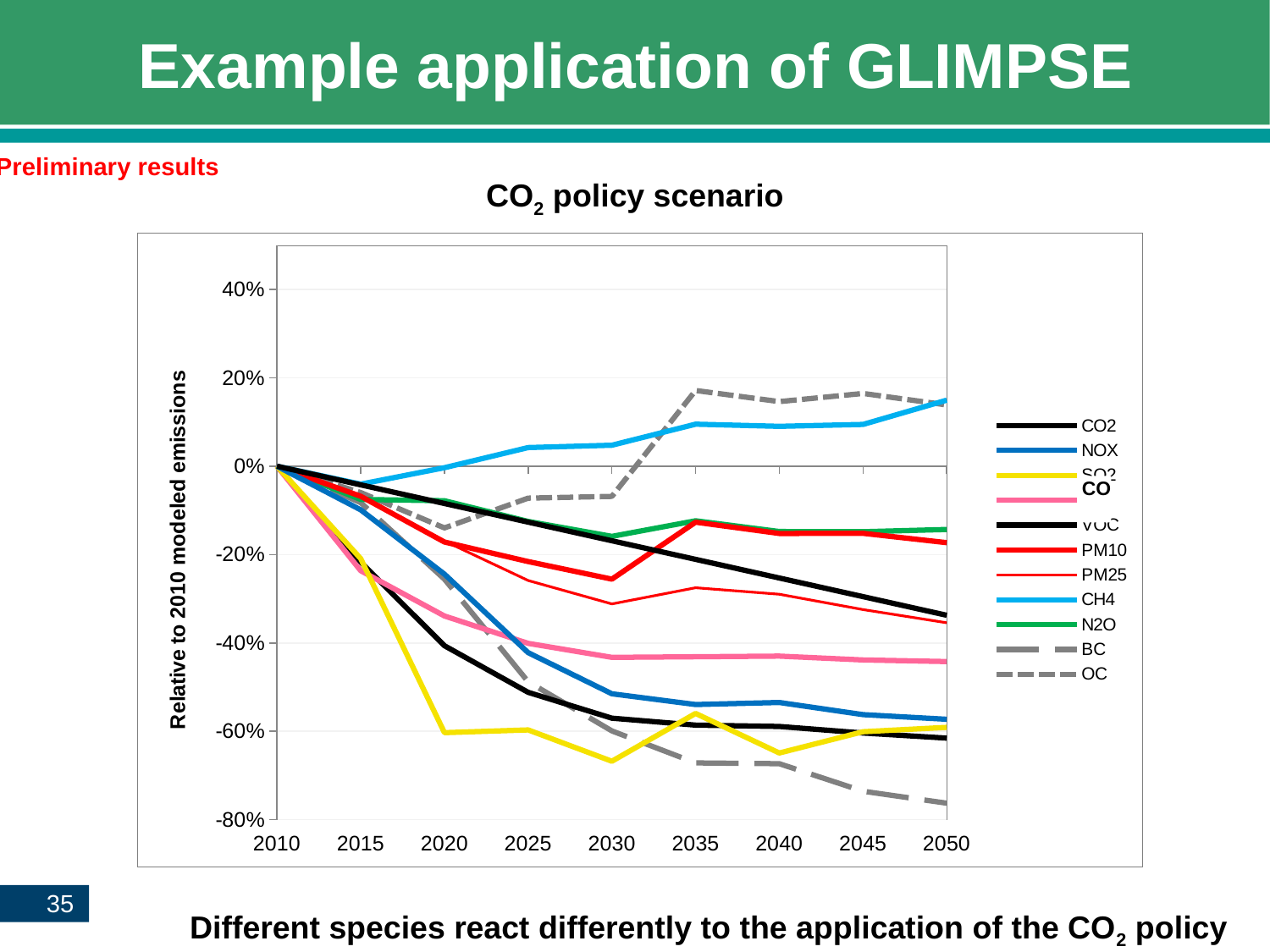
Which series has the highest value in 2035? OC In 2030, which is higher, CH4 or N2O? CH4 Which series has the lowest value in 2050? BC How many years are marked along the x axis of the chart? 9 Does the CH4 line rise or fall from 2010 to 2050? rise Does the CO2 line rise or fall from 2010 to 2050? fall What kind of chart is shown on the slide? line chart What is the value for CO2 in 2010? 0% How many series does the chart legend list? 11 What is the title of the chart's vertical axis? Relative to 2010 modeled emissions Is the value for CH4 in 2050 greater or less than 0%? greater Is the value for BC in 2050 greater or less than -60%? less